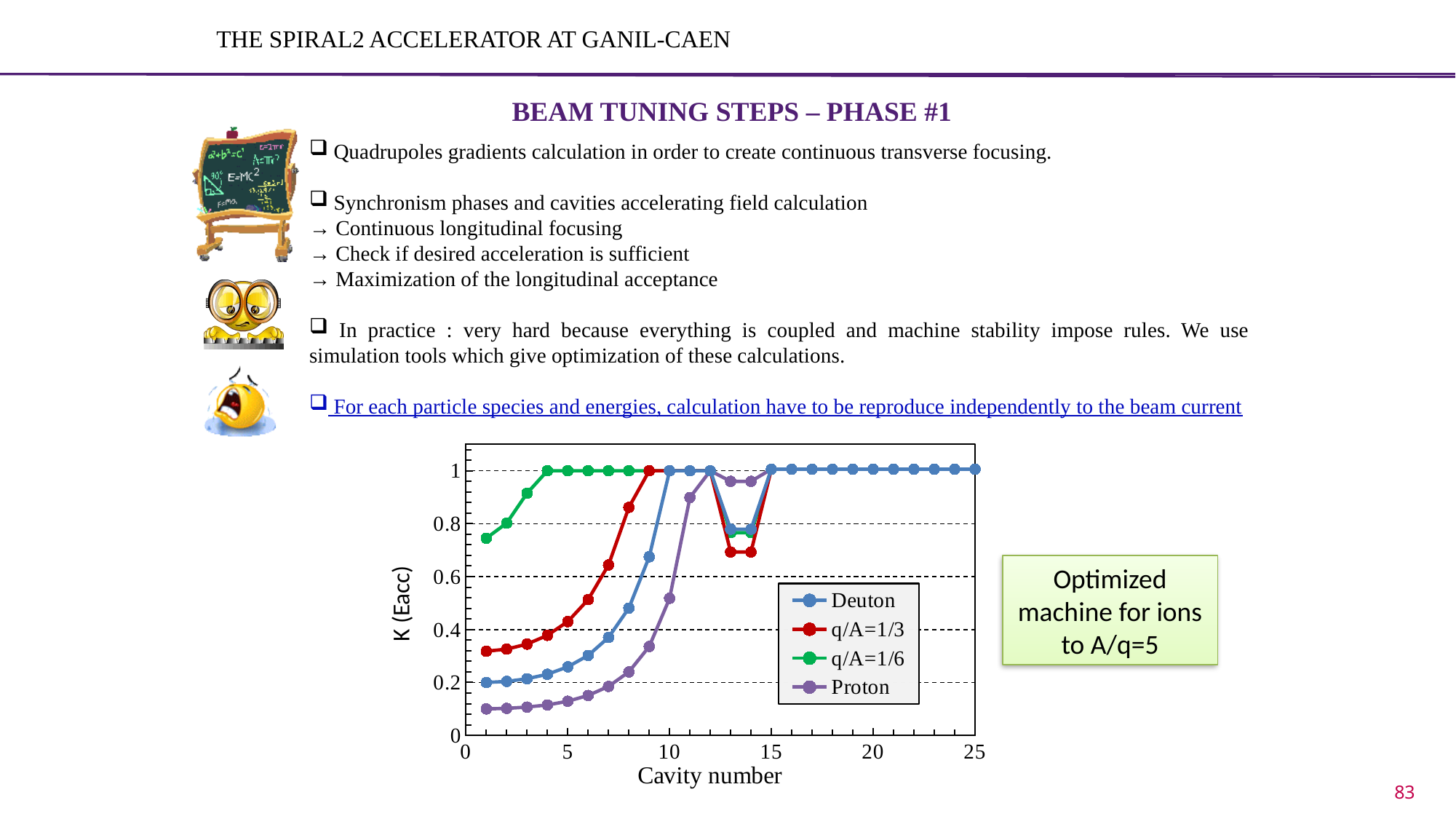
Is the value for the Proton series at cavity number 1 greater or less than 0.2? less What is the value of K (Eacc) for the q/A=1/6 series at cavity number 5? 1 How many series does the chart legend list? 4 Which series has the lowest K (Eacc) value at cavity number 1? Proton Is the value for the q/A=1/6 series at cavity number 1 greater or less than 0.6? greater Which series has the highest K (Eacc) value at cavity number 1? q/A=1/6 What kind of chart is shown on the slide? line chart Is the value for the q/A=1/3 series at cavity number 1 greater or less than 0.2? greater What is the label of the x axis of the chart? Cavity number Which series are listed in the chart legend? Deuton, q/A=1/3, q/A=1/6, Proton Do the K (Eacc) values for the Proton series rise or fall between cavity number 1 and cavity number 10? rise